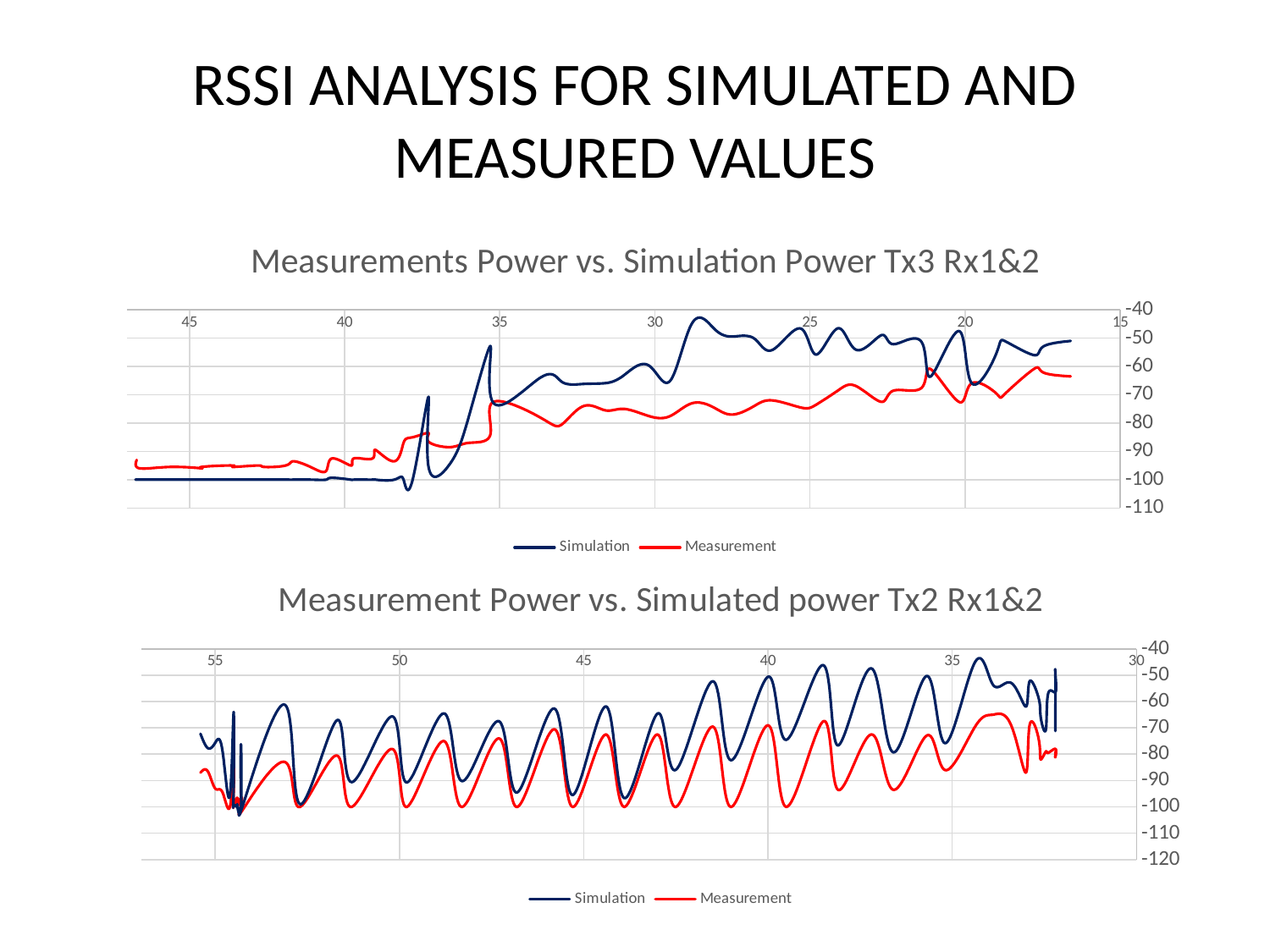
How many series does the legend of the bottom chart list? 2 In the bottom chart, is the Measurement value at x = 55 greater or less than -80? less In the bottom chart, what is the lowest value shown on the vertical axis? -120 How many series does the legend of the top chart list? 2 In the top chart, is the Measurement value at x = 45 greater or less than -90? less In the top chart, does the Measurement series generally rise or fall moving from left to right along the x axis? rise In the top chart, is the Simulation value at x = 45 greater or less than -90? less In the top chart, which colour is used for the Measurement series? red What kind of chart is the top chart titled "Measurements Power vs. Simulation Power Tx3 Rx1&2"? line chart In the top chart, at x = 25, which series has the higher value, Simulation or Measurement? Simulation What kind of chart is the bottom chart titled "Measurement Power vs. Simulated power Tx2 Rx1&2"? line chart